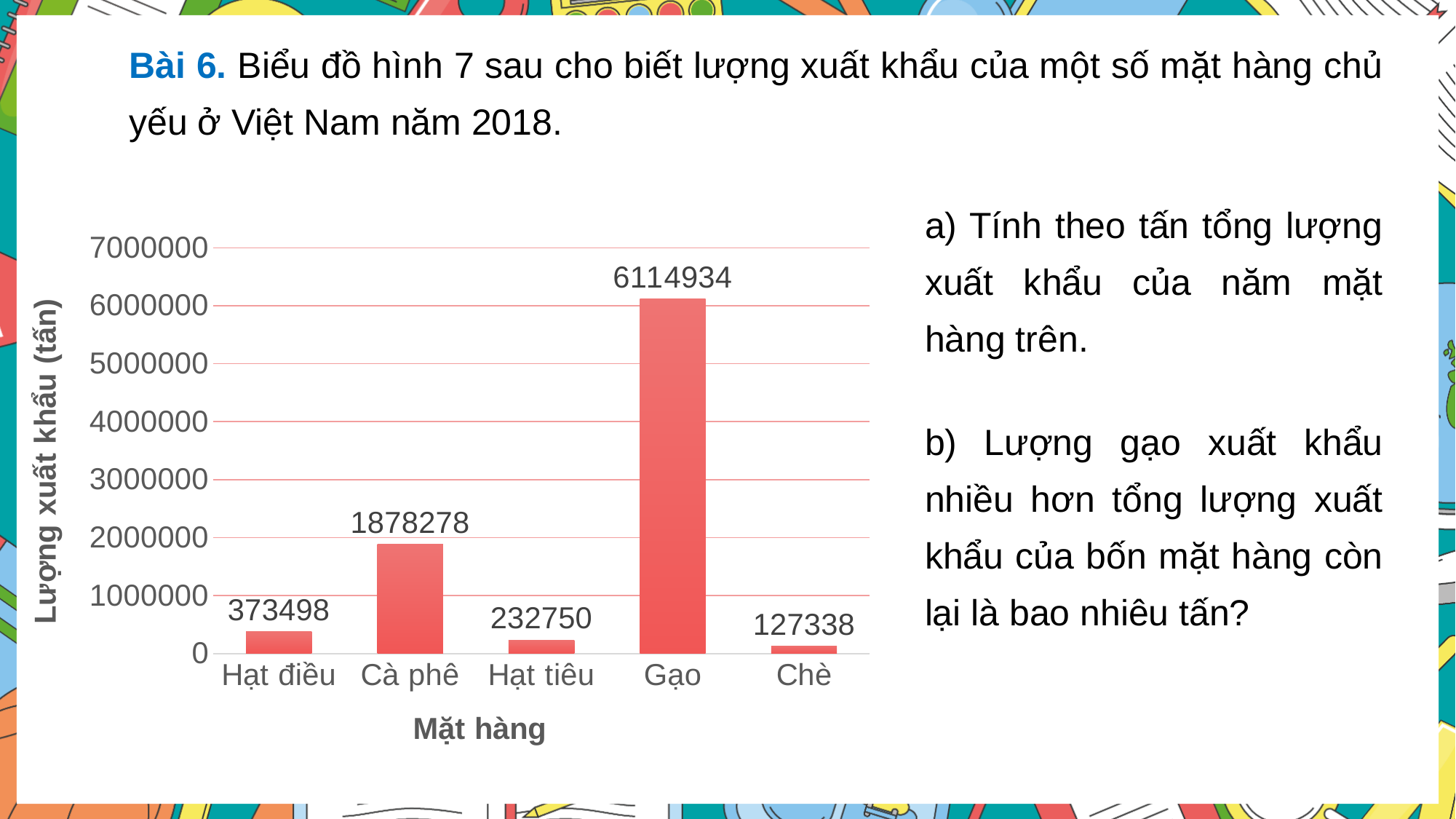
What is the difference between the export volumes of Hạt điều and Hạt tiêu? 140748 What is the difference between the export volumes of Gạo and Cà phê? 4236656 How many products are shown in the chart? 5 Which has a larger export volume, Hạt điều or Hạt tiêu? Hạt điều What is the label of the vertical axis? Lượng xuất khẩu (tấn) Which product has the lowest export volume? Chè Is the value for Cà phê greater or less than 2000000? less What is the export volume for Gạo? 6114934 What is the export volume for Cà phê? 1878278 What is the export volume for Chè? 127338 Which product has the highest export volume? Gạo What kind of chart is shown on the slide? bar chart